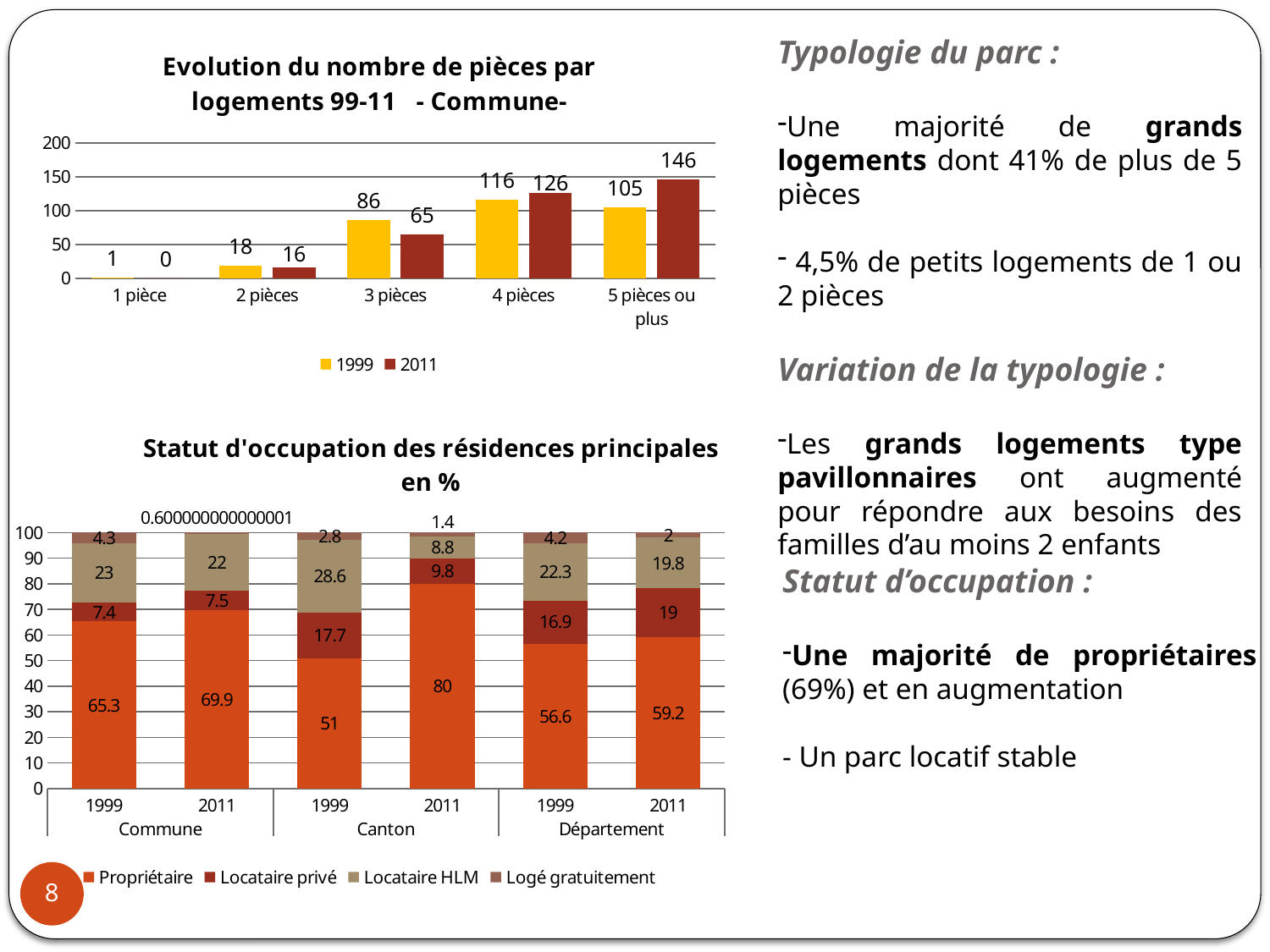
In the top chart 'Evolution du nombre de pièces par logements 99-11 - Commune-', what is the value for '5 pièces ou plus' in 2011? 146 In the top chart 'Evolution du nombre de pièces par logements 99-11 - Commune-', what is the value for '3 pièces' in 1999? 86 What kind of chart is the bottom chart 'Statut d'occupation des résidences principales en %'? Stacked bar chart In the bottom chart 'Statut d'occupation des résidences principales en %', how many series does the legend list? 4 In the top chart 'Evolution du nombre de pièces par logements 99-11 - Commune-', which is larger for '3 pièces': the 1999 value or the 2011 value? 1999 In the top chart 'Evolution du nombre de pièces par logements 99-11 - Commune-', how many categories are shown on the x axis? 5 In the bottom chart 'Statut d'occupation des résidences principales en %', what is the Locataire HLM value for Commune in 1999? 23 In the top chart 'Evolution du nombre de pièces par logements 99-11 - Commune-', what is the difference between the 2011 and 1999 values for '5 pièces ou plus'? 41 In the bottom chart 'Statut d'occupation des résidences principales en %', what is the difference between the Propriétaire values for Commune in 2011 and 1999? 4.6 In the top chart 'Evolution du nombre de pièces par logements 99-11 - Commune-', which category has the highest value for 1999? 4 pièces In the bottom chart 'Statut d'occupation des résidences principales en %', what is the Propriétaire value for Canton in 2011? 80 In the top chart 'Evolution du nombre de pièces par logements 99-11 - Commune-', how many series does the legend list? 2